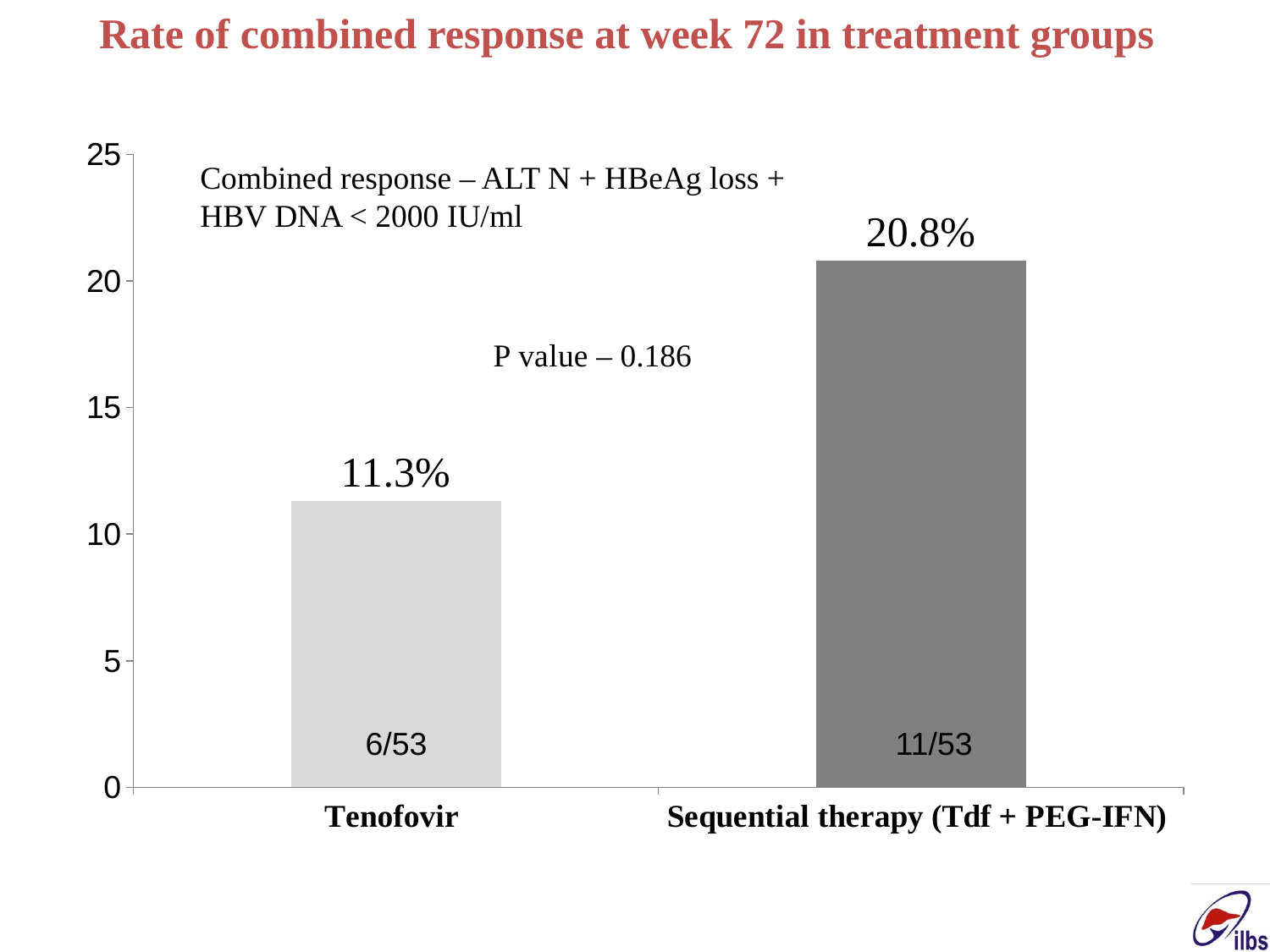
Is the combined response rate for Tenofovir greater or less than 15? less How many patients out of 53 achieved combined response in the Tenofovir group? 6/53 How many patients out of 53 achieved combined response in the Sequential therapy group? 11/53 How many treatment groups are shown in the chart? 2 Which treatment group has the higher combined response rate? Sequential therapy (Tdf + PEG-IFN) What type of chart is shown on the slide? Bar chart Is the combined response rate for Sequential therapy greater or less than 20? greater Which treatment group has the lower combined response rate? Tenofovir What P value is reported on the chart? 0.186 What is the difference in combined response rate between the Sequential therapy group and the Tenofovir group? 9.5% What is the combined response rate for the Sequential therapy (Tdf + PEG-IFN) group? 20.8% What is the combined response rate for the Tenofovir group? 11.3%